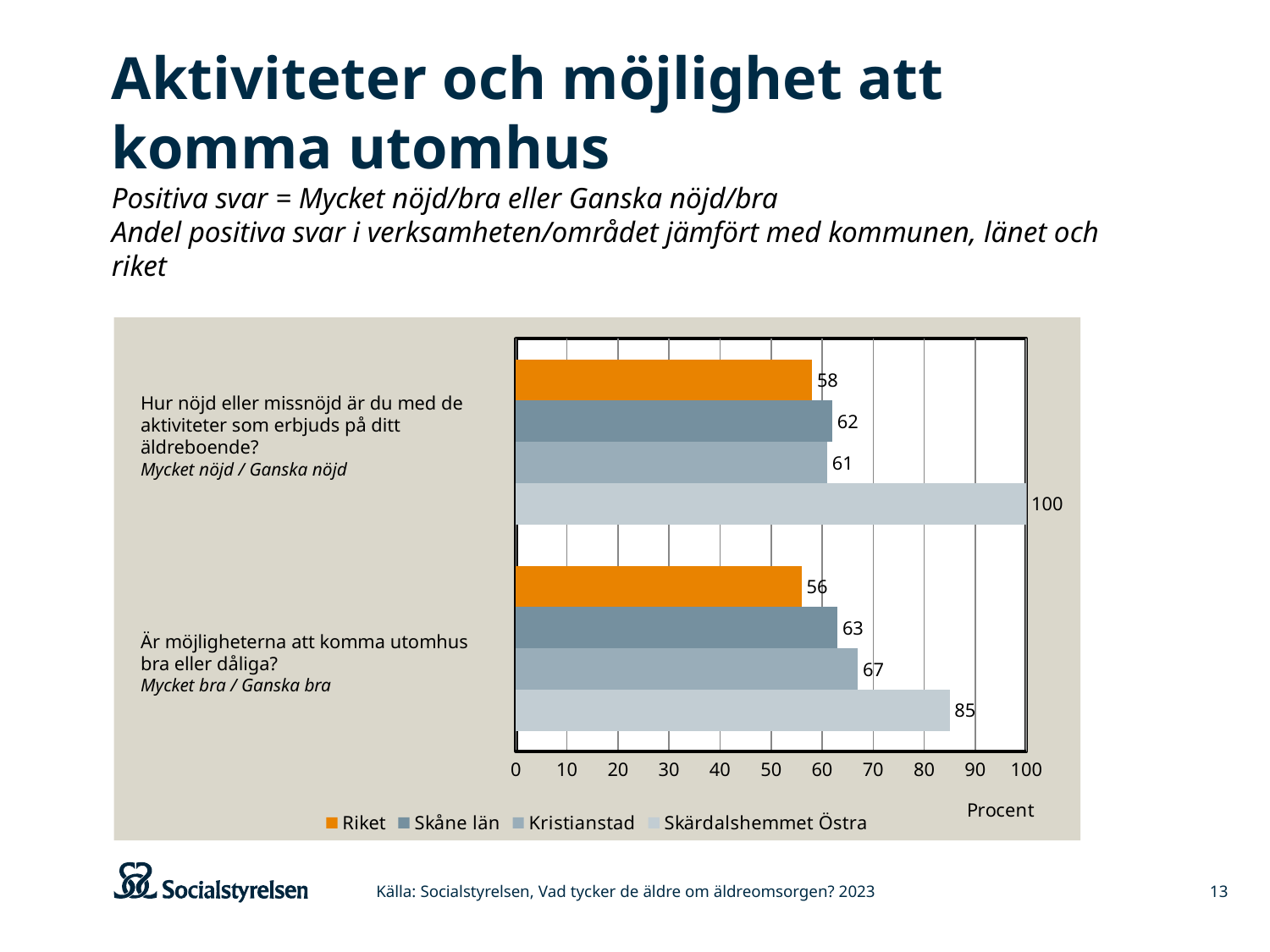
Which series has the lowest value on the question about satisfaction with activities offered at the care home? Riket Which is larger on the question "Är möjligheterna att komma utomhus bra eller dåliga?": Skåne län or Kristianstad? Kristianstad What is the value for Skärdalshemmet Östra on the question about satisfaction with activities offered at the care home ("Hur nöjd eller missnöjd är du med de aktiviteter som erbjuds på ditt äldreboende?")? 100 What is the difference between Skärdalshemmet Östra and Riket on the question "Är möjligheterna att komma utomhus bra eller dåliga?"? 29 What kind of chart is shown on the slide? Bar chart What is the value for Skåne län on the question about satisfaction with activities offered at the care home? 62 How many series does the legend list? 4 What is the value for Kristianstad on the question "Är möjligheterna att komma utomhus bra eller dåliga?"? 67 What is the label of the x axis of the chart? Procent Which series has the highest value on the question "Är möjligheterna att komma utomhus bra eller dåliga?"? Skärdalshemmet Östra What is the value for Riket on the question "Är möjligheterna att komma utomhus bra eller dåliga?"? 56 What is the difference between Skärdalshemmet Östra and Kristianstad on the question about satisfaction with activities offered at the care home? 39